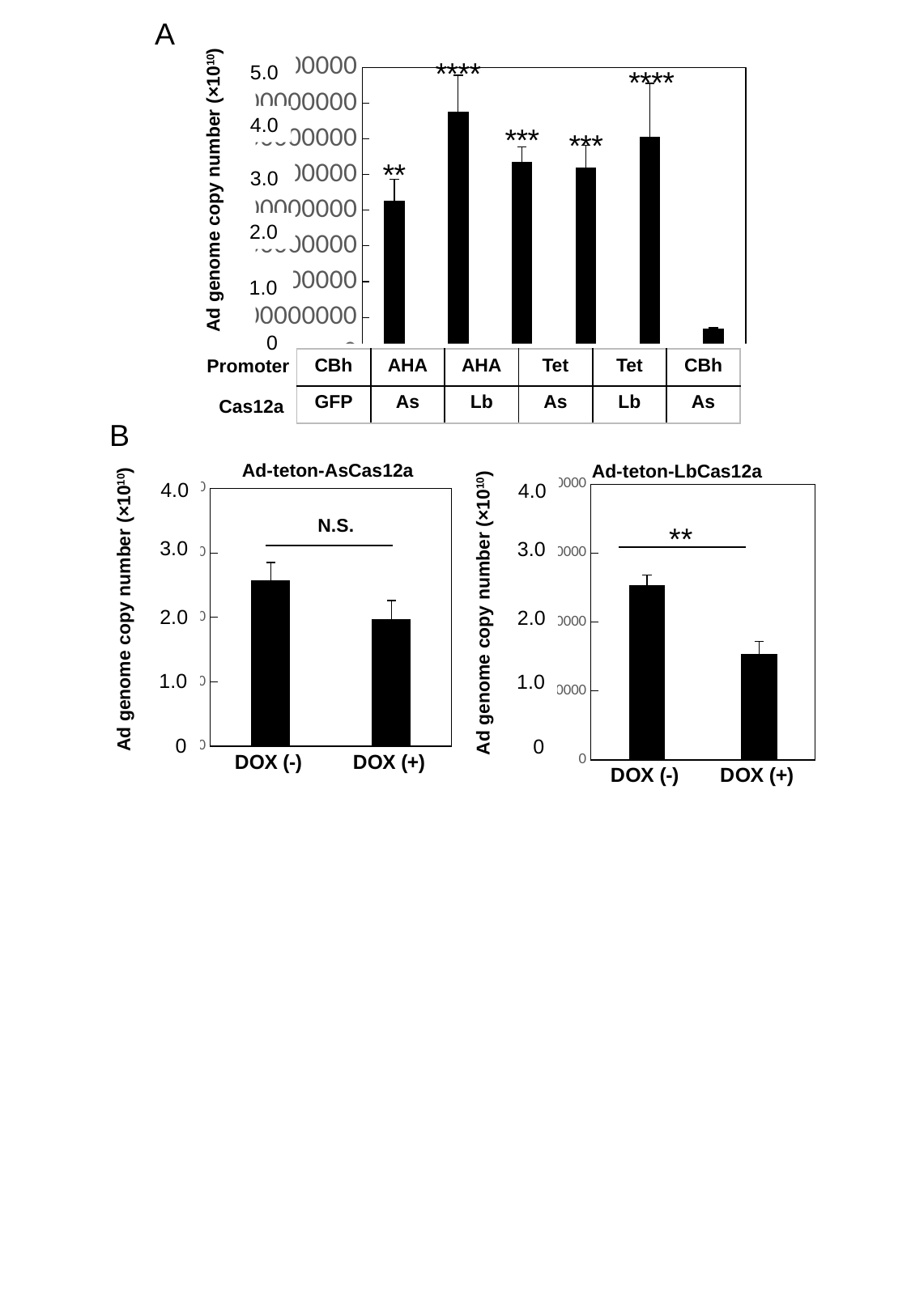
In the panel A chart, is the value for the CBh promoter with AsCas12a greater or less than 1.0? less What kind of chart is shown in panel A? bar chart In the panel A chart, which is larger: the value for AHA/Lb or the value for Tet/Lb? Tet/Lb In the Ad-teton-LbCas12a chart, is the value for DOX (+) greater or less than 2.0? less In the panel A chart, is the value for the AHA promoter with LbCas12a greater or less than 4.0? less In the Ad-teton-AsCas12a chart, which is larger: DOX (-) or DOX (+)? DOX (-) What is the y-axis label of the Ad-teton-AsCas12a chart? Ad genome copy number (×10^10) In the panel A chart, which is larger: the value for AHA/As or the value for Tet/As? AHA/As In the panel A chart, which promoter/Cas12a combination has the highest Ad genome copy number? AHA / As In the panel A chart, how many bars (promoter/Cas12a combinations) are plotted? 6